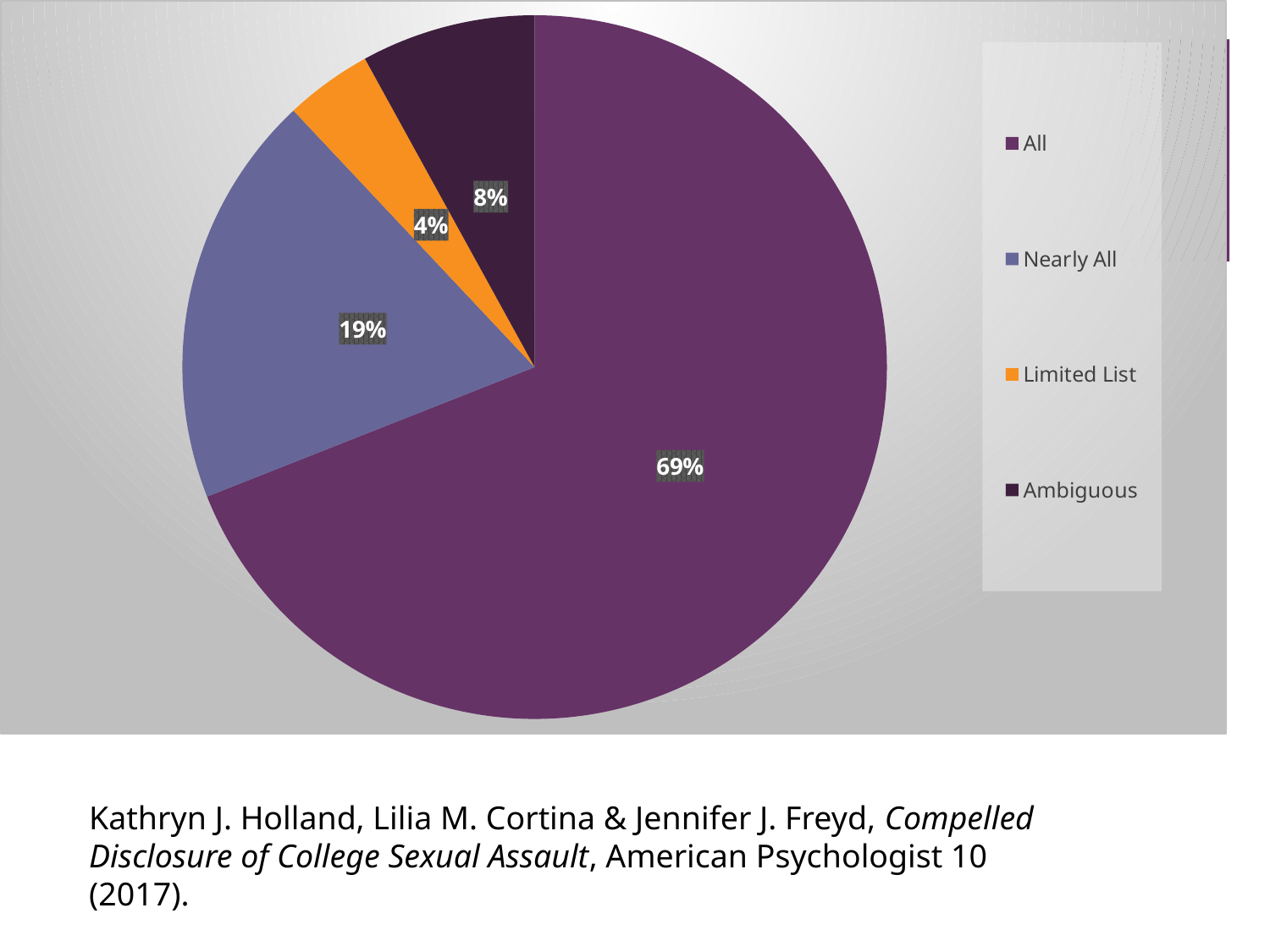
Which slice is larger, "Ambiguous" or "Limited List"? Ambiguous What percentage of the pie is labelled "Ambiguous"? 8% What colour is the "Limited List" slice? orange Which category has the smallest slice of the pie? Limited List How many entries does the legend list? 4 Which category has the largest slice of the pie? All What percentage of the pie is labelled "Limited List"? 4% What kind of chart is shown on the slide? pie chart How many slices does the pie chart have? 4 What percentage of the pie is labelled "All"? 69% What is the difference in percentage points between the "All" slice and the "Nearly All" slice? 50 What percentage of the pie is labelled "Nearly All"? 19%